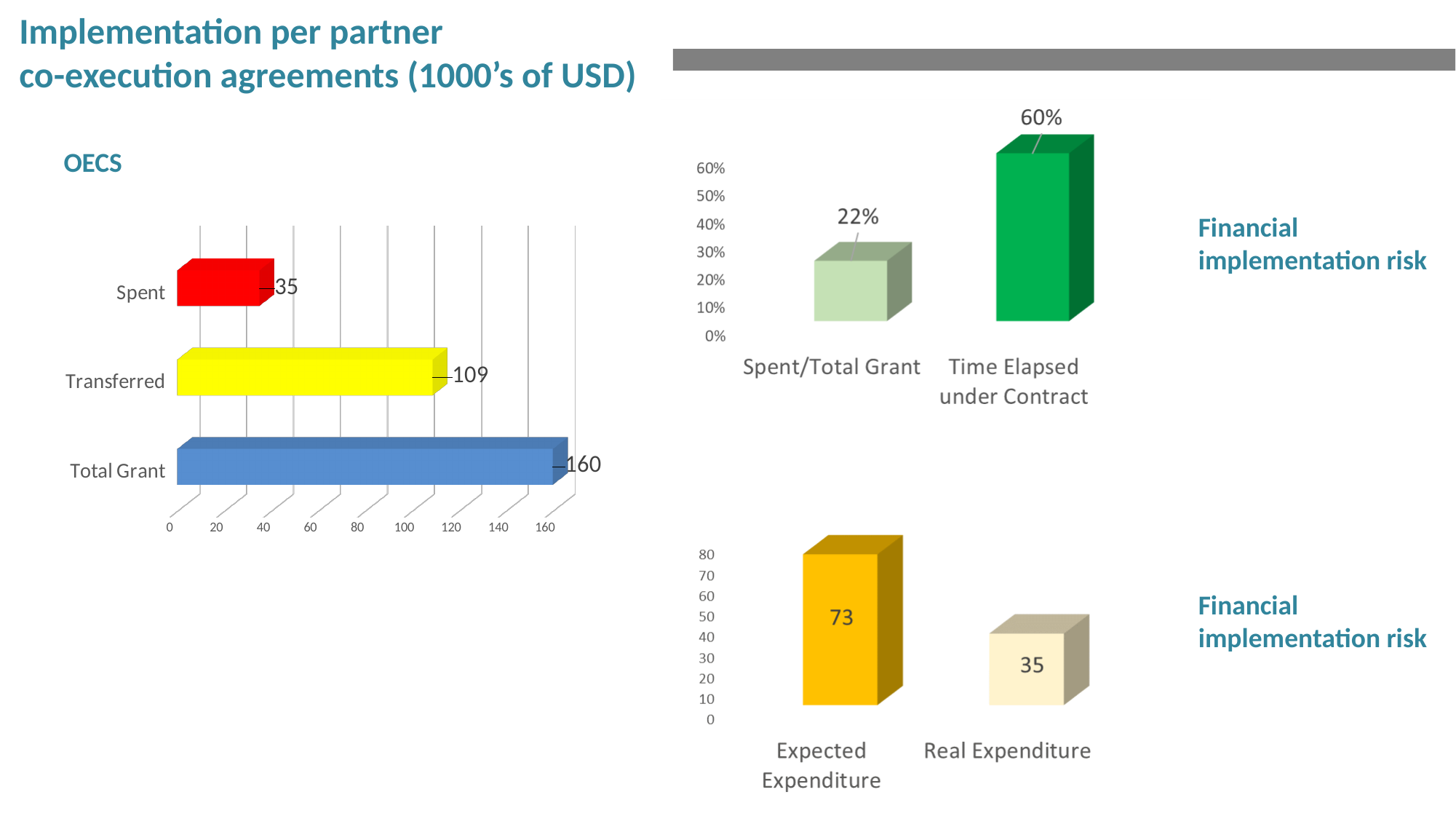
What kind of chart is the OECS chart on the left? Bar chart In the OECS chart on the left, what is the difference between Total Grant and Transferred? 51 In the top-right chart, what is the value for Spent/Total Grant? 22% In the bottom-right chart, what is the difference between Expected Expenditure and Real Expenditure? 38 In the OECS chart on the left, what is the value for Spent? 35 In the bottom-right chart, what is the value for Expected Expenditure? 73 In the OECS chart on the left, how many categories are shown? 3 In the OECS chart on the left, what is the value for Transferred? 109 In the OECS chart on the left, what is the value for Total Grant? 160 In the OECS chart on the left, which category has the lowest value? Spent In the top-right chart, what is the value for Time Elapsed under Contract? 60% In the top-right chart, which is larger, Spent/Total Grant or Time Elapsed under Contract? Time Elapsed under Contract